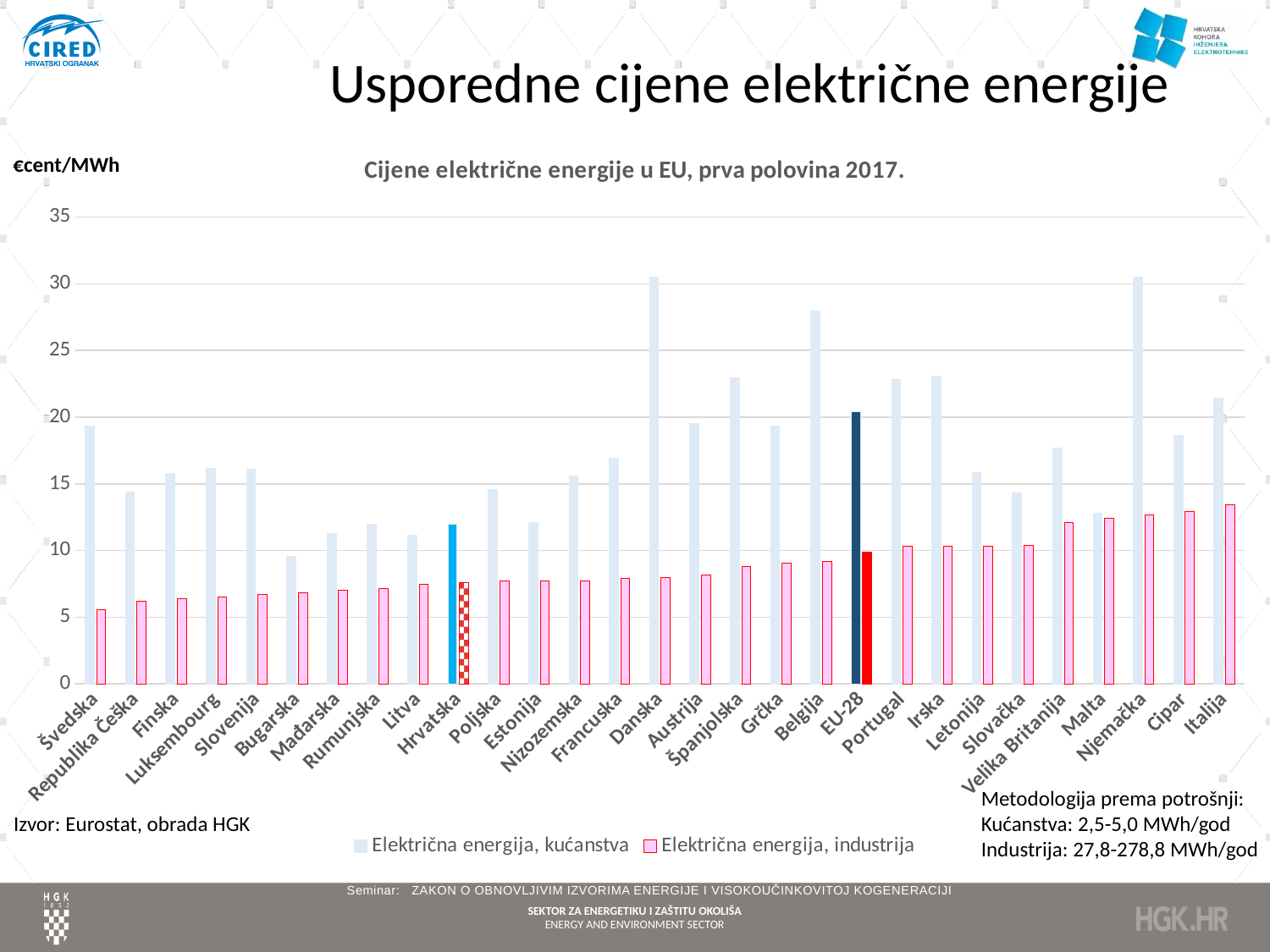
Is the value for Električna energija, kućanstva for EU-28 greater or less than 15? greater What kind of chart is shown on the slide? bar chart How many countries/categories are shown on the x axis? 29 Which country has the lowest value for Električna energija, industrija? Švedska Do the values for Električna energija, industrija generally rise or fall from left to right along the x axis? rise Is the value for Električna energija, kućanstva for Belgija greater or less than 25? greater How many series does the legend list? 2 Which is larger, the Električna energija, kućanstva value for Danska or for Hrvatska? Danska What is the title of the chart? Cijene električne energije u EU, prva polovina 2017. Which country has the lowest value for Električna energija, kućanstva? Bugarska Is the value for Električna energija, industrija for Švedska greater or less than 10? less What are the two legend entries of the chart? Električna energija, kućanstva; Električna energija, industrija